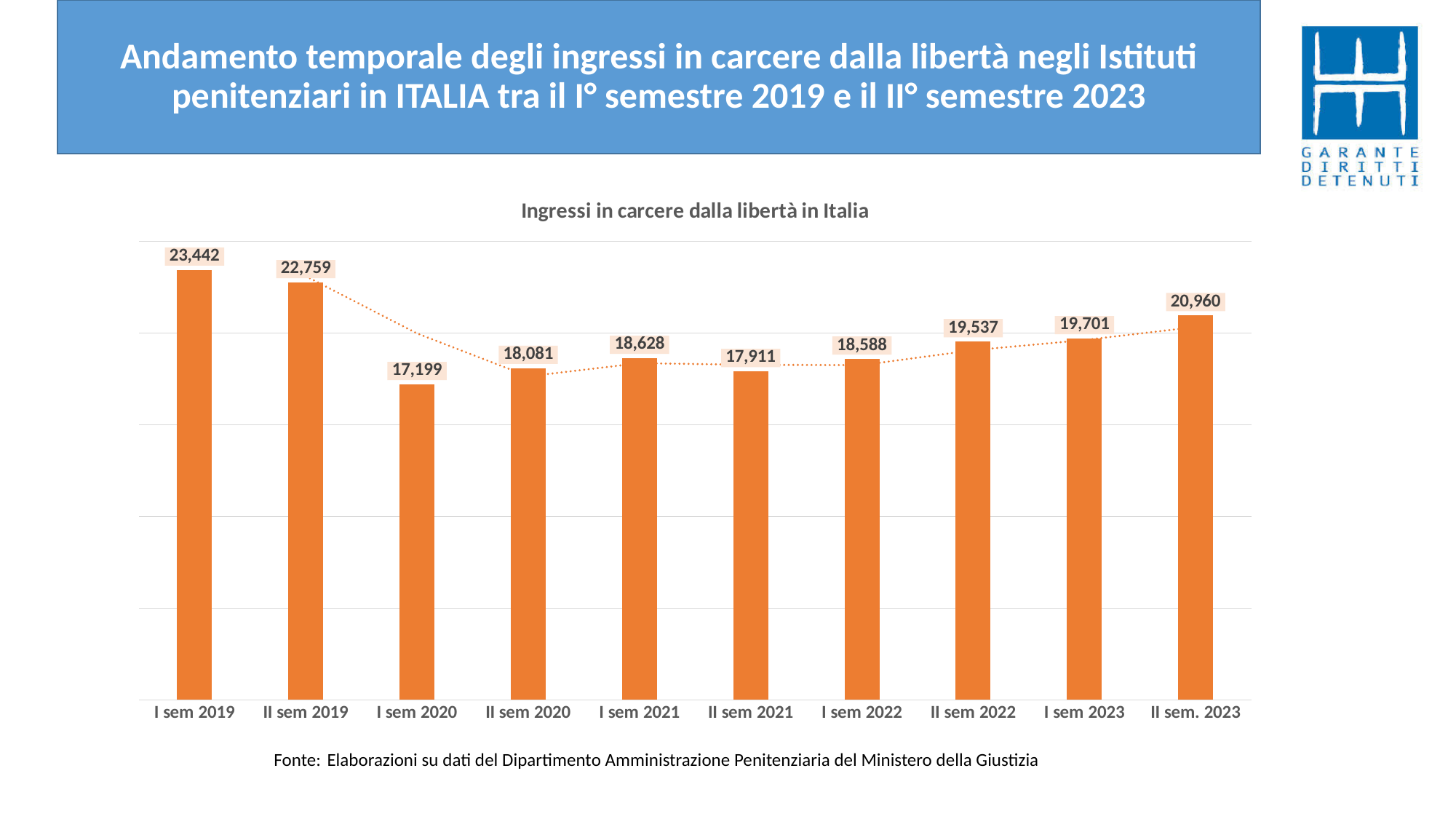
Which is larger, the value for II sem 2020 or the value for II sem 2021? II sem 2020 What is the value for I sem 2019? 23,442 What is the difference between the values for I sem 2019 and I sem 2020? 6,243 What is the value for II sem. 2023? 20,960 What is the value for II sem 2021? 17,911 What kind of chart is shown on the slide? Bar chart How many semesters are shown on the x axis? 10 Which semester has the lowest value? I sem 2020 Which is larger, the value for I sem 2021 or the value for I sem 2022? I sem 2021 What is the title of the chart? Ingressi in carcere dalla libertà in Italia What is the difference between the values for II sem. 2023 and I sem 2023? 1,259 Which semester has the highest value? I sem 2019